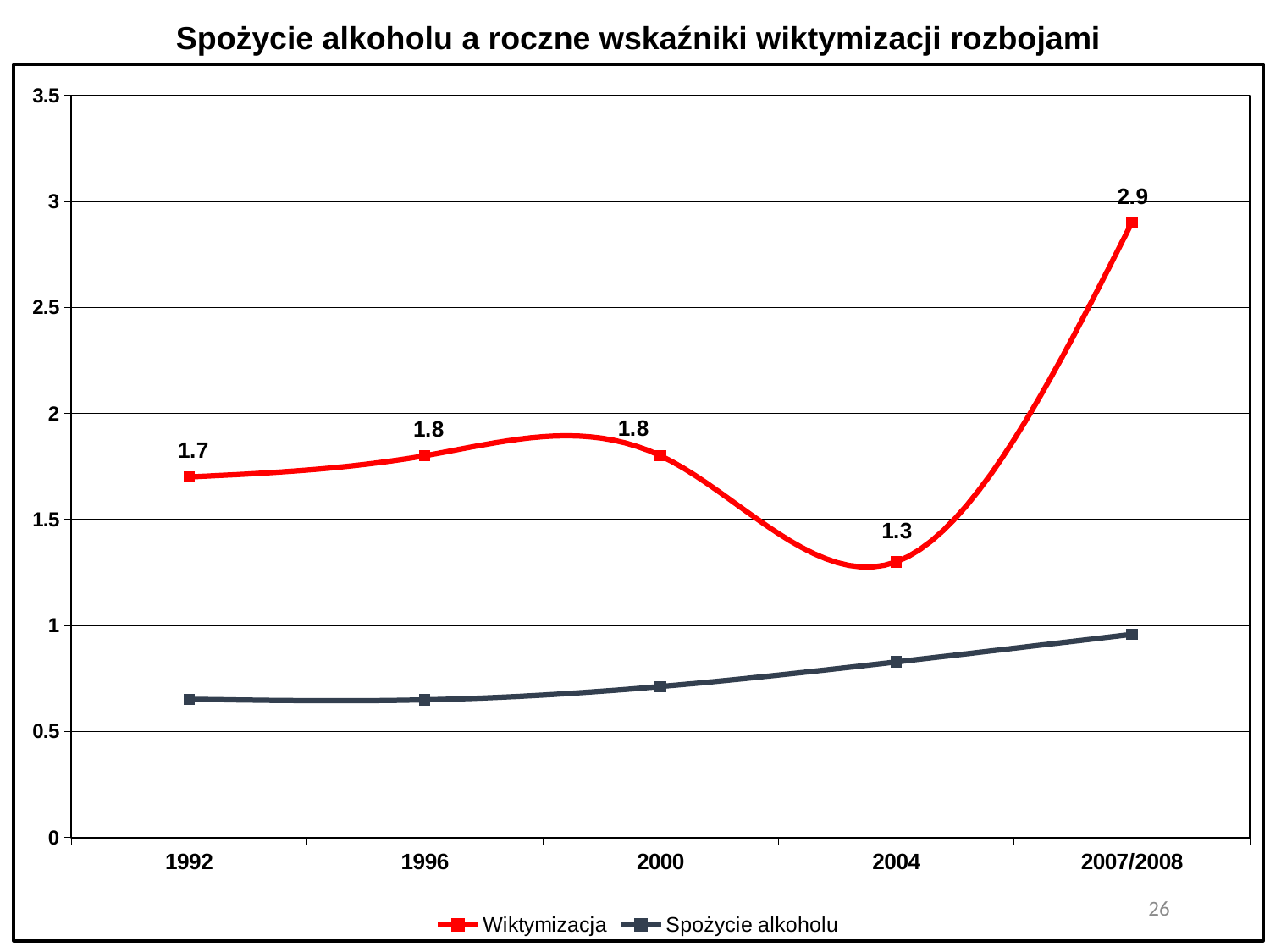
Is the Spożycie alkoholu value for 2007/2008 greater or less than 1? less How many points are plotted on the x axis? 5 Is the Spożycie alkoholu value for 1992 greater or less than 0.5? greater Which is larger, the Wiktymizacja value for 1996 or for 2004? 1996 What is the Wiktymizacja value for 2004? 1.3 What kind of chart is shown? line chart In which year is the Wiktymizacja value lowest? 2004 What is the Wiktymizacja value for 2007/2008? 2.9 In which year is the Wiktymizacja value highest? 2007/2008 What is the difference between the Wiktymizacja values for 2007/2008 and 2004? 1.6 What is the Wiktymizacja value for 1992? 1.7 How many series does the legend list? 2